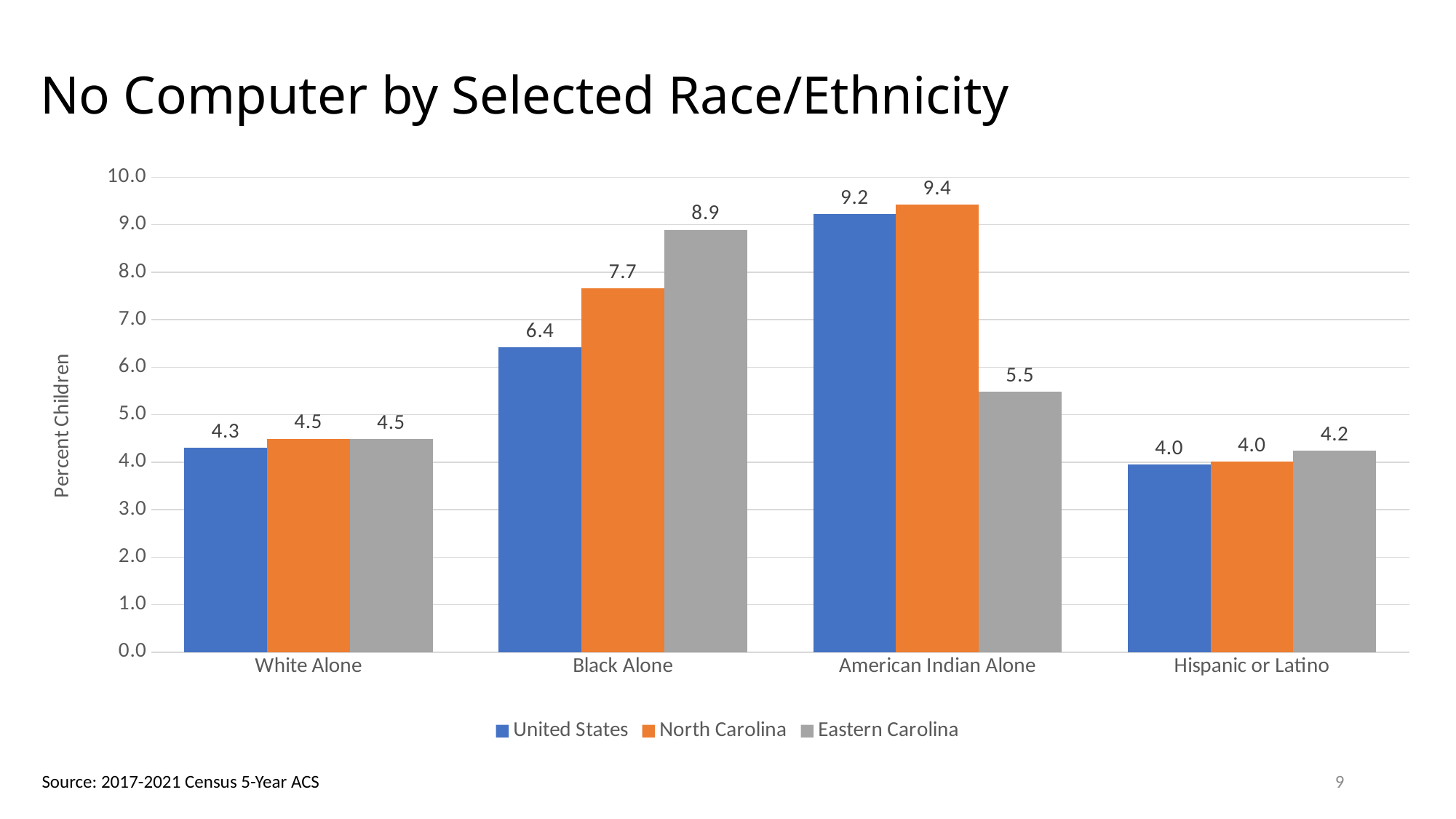
Which category has the highest North Carolina value? American Indian Alone What is the Eastern Carolina value for Black Alone? 8.9 What is the label on the vertical axis? Percent Children What is the United States value for Hispanic or Latino? 4.0 How many race/ethnicity categories are shown on the x axis? 4 What is the difference between the North Carolina and Eastern Carolina values for American Indian Alone? 3.9 Is the United States value for American Indian Alone greater or less than 8.0? greater What is the North Carolina value for American Indian Alone? 9.4 What kind of chart is shown on the slide? bar chart How many series does the legend list? 3 For Black Alone, which is larger: the United States value or the Eastern Carolina value? Eastern Carolina Which category has the lowest Eastern Carolina value? Hispanic or Latino